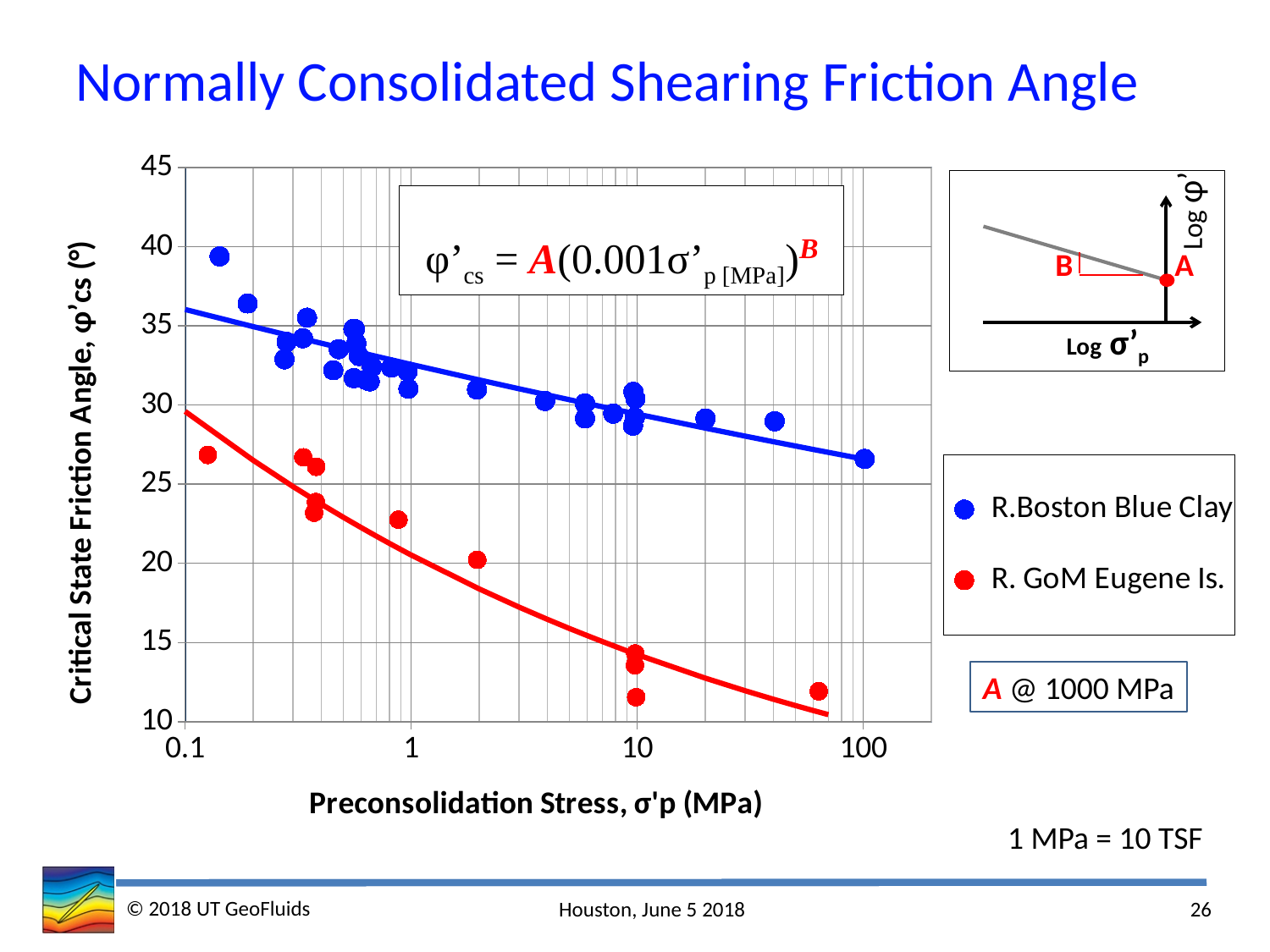
Is the lowest R. GoM Eugene Is. point greater or less than 15? less Is the leftmost R. GoM Eugene Is. point greater or less than 25? greater What kind of chart is shown on the slide? scatter chart What are the two series named in the chart legend? R.Boston Blue Clay and R. GoM Eugene Is. At 10 MPa, which series has the higher critical state friction angle, R.Boston Blue Clay or R. GoM Eugene Is.? R.Boston Blue Clay How many series does the chart legend list? 2 Is the highest R.Boston Blue Clay point greater or less than 35? greater What is the title of the x axis of the chart? Preconsolidation Stress, σ'p (MPa) As preconsolidation stress increases along the x axis, do the critical state friction angles for both series rise or fall? fall Which series has the higher critical state friction angles overall, R.Boston Blue Clay or R. GoM Eugene Is.? R.Boston Blue Clay